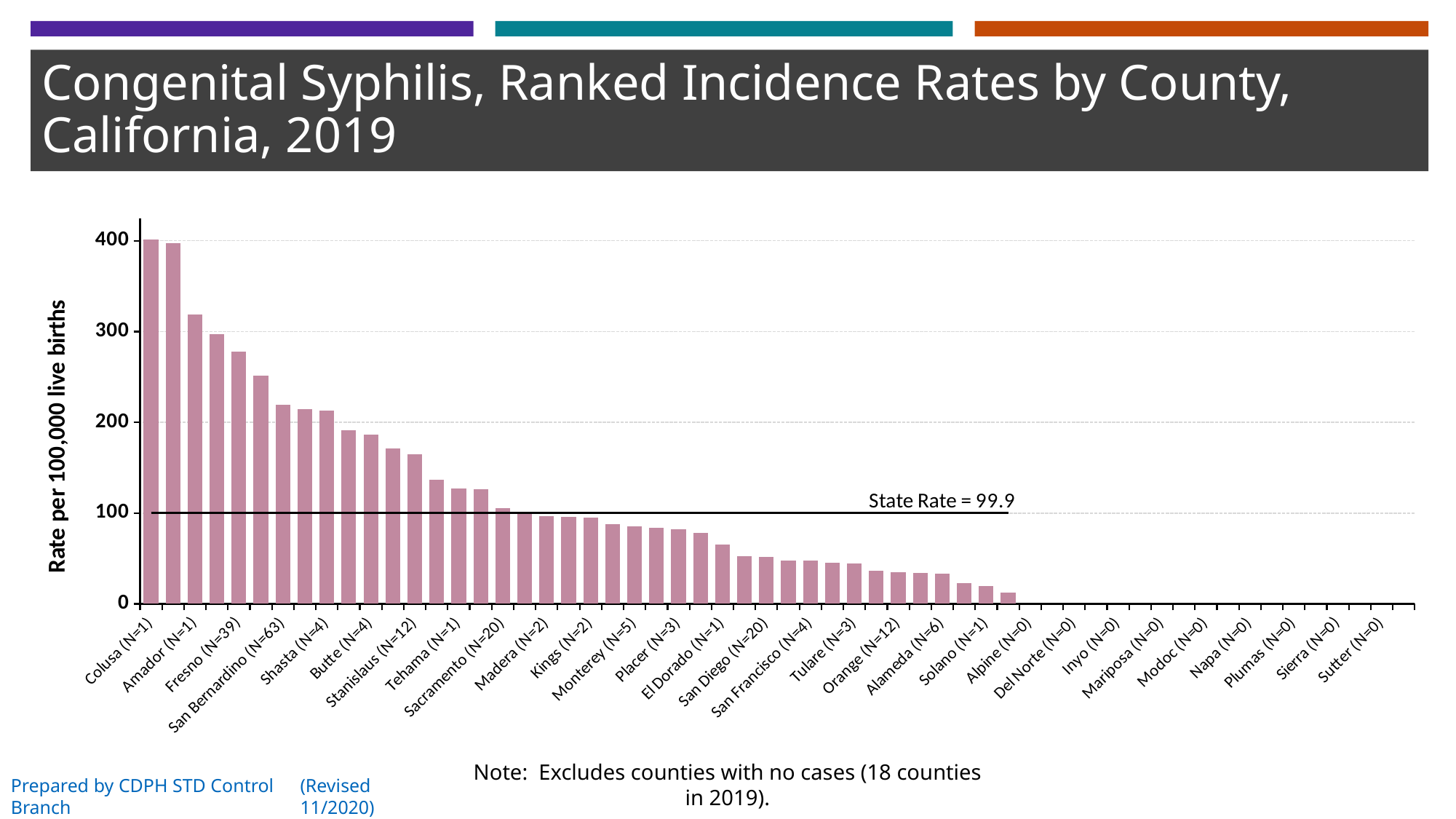
Which has a higher rate, Fresno or Alameda? Fresno Which has a higher rate, Colusa or Solano? Colusa Which county has the highest congenital syphilis incidence rate on the chart? Colusa Is the value for Colusa greater or less than 300? greater Is the value for Kings greater or less than 100? less Is the value for Fresno greater or less than 200? greater What kind of chart is shown on the slide? bar chart What is the state rate shown by the horizontal reference line on the chart? 99.9 Do the bar values rise or fall moving from left to right along the x axis? fall What is the title of the y axis? Rate per 100,000 live births